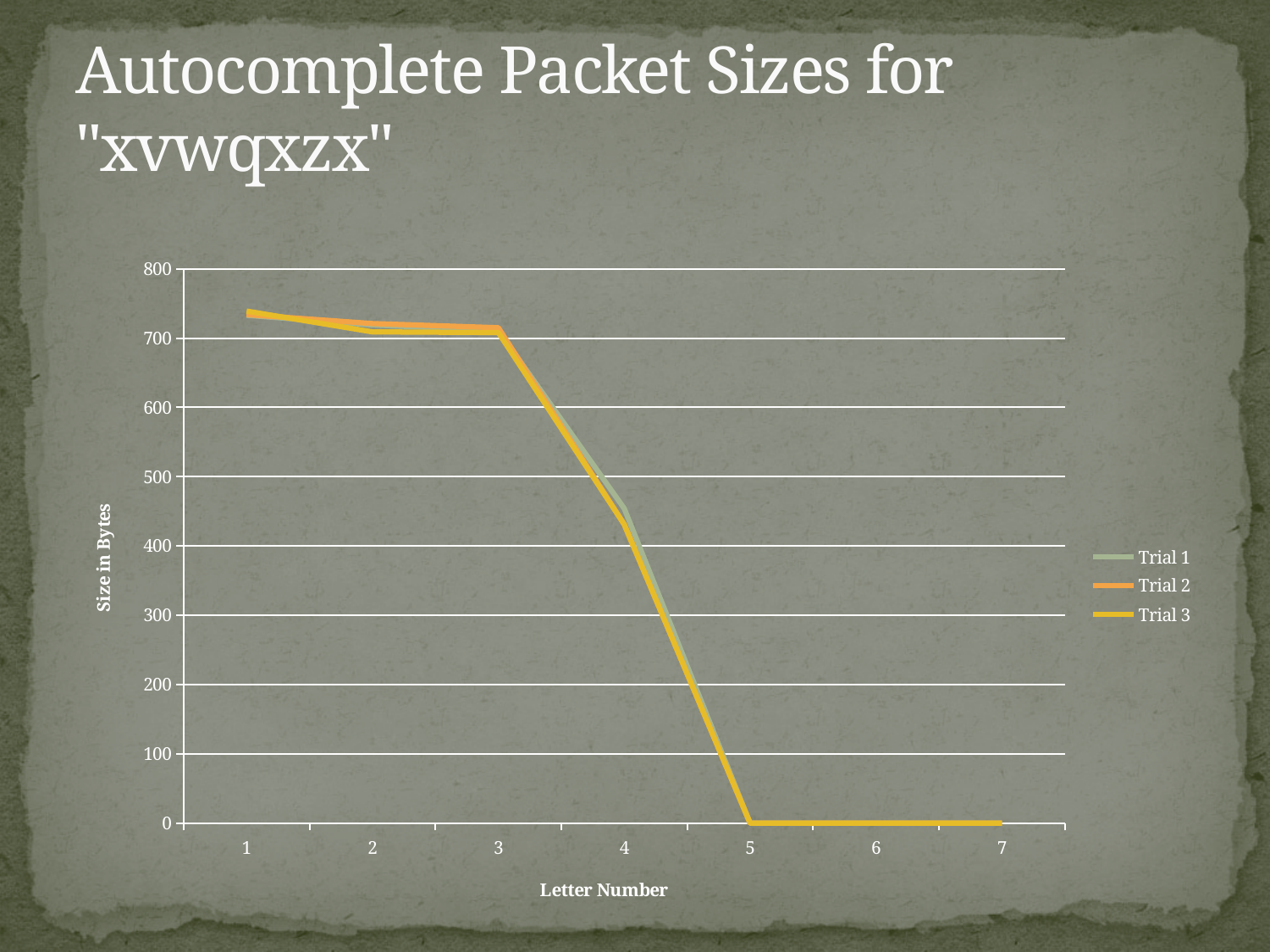
What is the value for Trial 1 at letter number 5? 0 What is the title of the chart's x axis? Letter Number What kind of chart is shown on the slide? line chart Is the value for Trial 2 at letter number 1 greater or less than 700? greater Do the packet sizes rise or fall as the letter number increases from 1 to 7? fall What is the title of the chart's y axis? Size in Bytes Is the value for Trial 3 at letter number 4 greater or less than 500? less For Trial 2, which is larger: the value at letter number 3 or the value at letter number 4? letter number 3 How many series does the legend list? 3 What is the value for Trial 3 at letter number 7? 0 How many letter numbers are plotted along the x axis? 7 Is the value for Trial 1 at letter number 3 greater or less than 600? greater